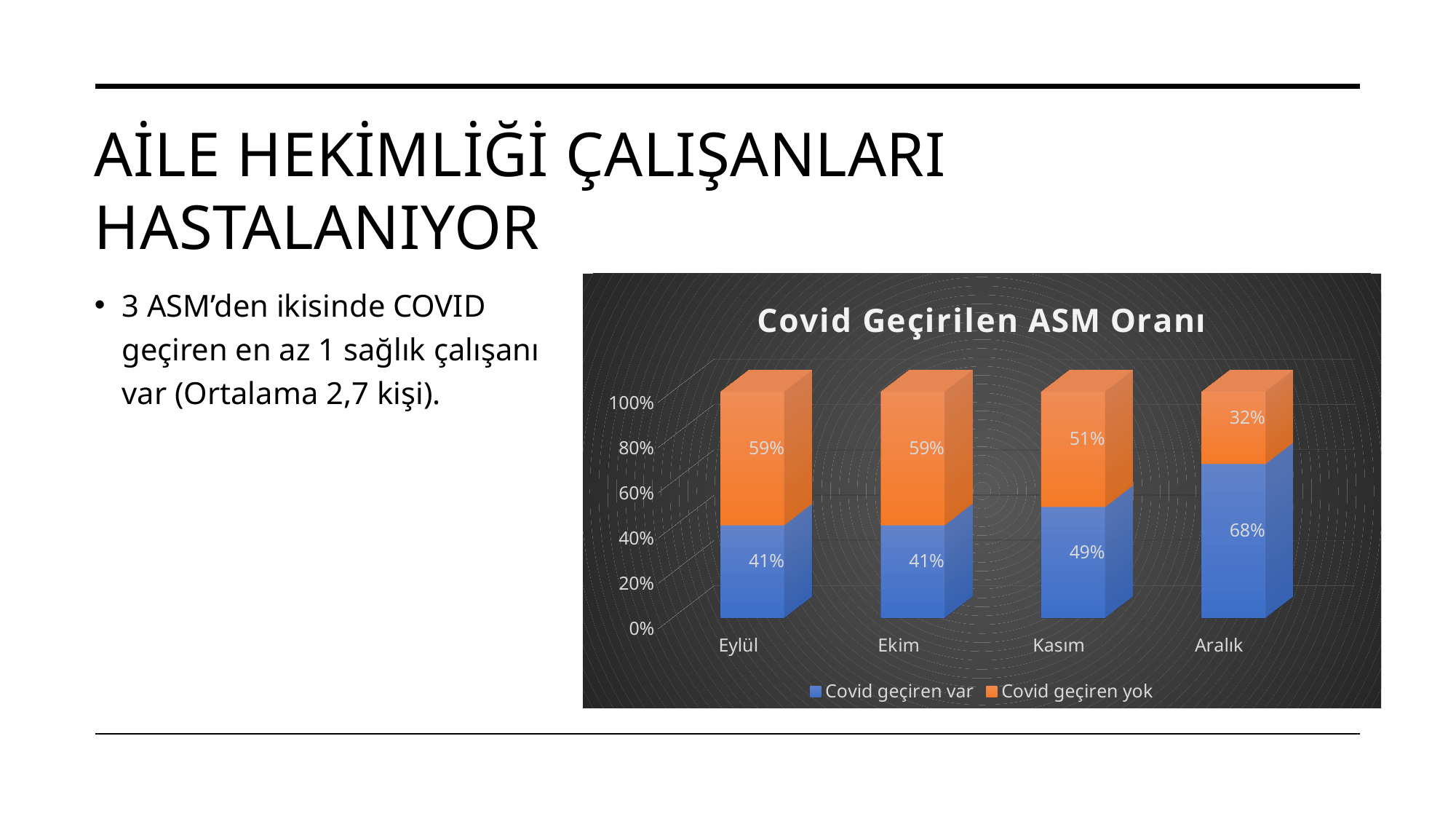
Which month has the lowest value for 'Covid geçiren yok'? Aralık What kind of chart is shown? Stacked bar chart Which month has the highest value for 'Covid geçiren var'? Aralık What is the value of 'Covid geçiren var' for Aralık? 68% How many months are shown on the x axis? 4 What is the value of 'Covid geçiren yok' for Kasım? 51% What is the title of the chart? Covid Geçirilen ASM Oranı What is the value of 'Covid geçiren var' for Eylül? 41% Which is larger: 'Covid geçiren yok' for Ekim or 'Covid geçiren yok' for Aralık? Ekim How many series does the legend list? 2 What is the difference between the 'Covid geçiren var' values for Aralık and Kasım? 19% Does the 'Covid geçiren var' value rise or fall from Eylül to Aralık? Rises